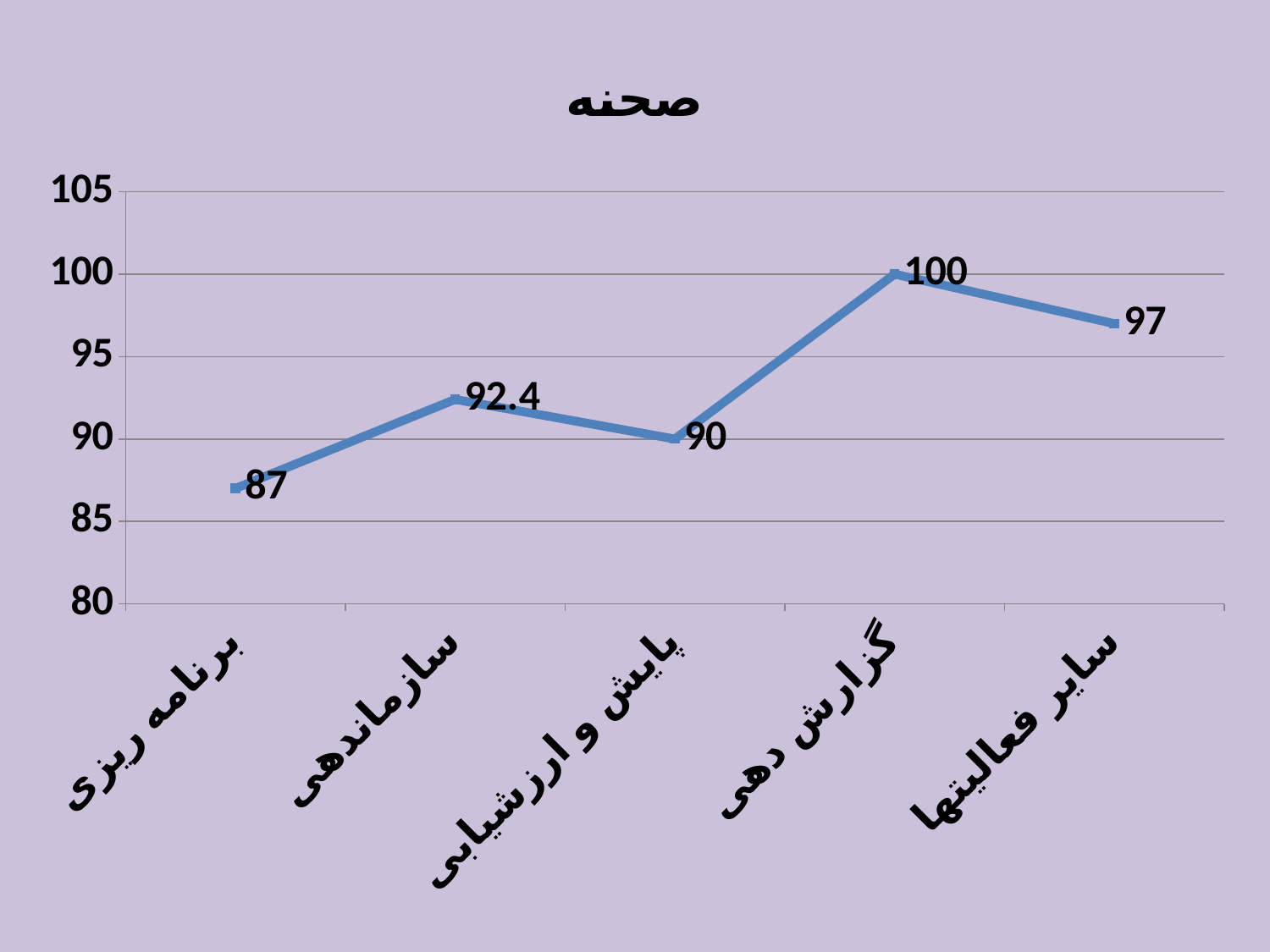
What is the value for سایر فعالیتها? 97 What is the difference between the values for گزارش دهی and پایش و ارزشیابی? 10 What kind of chart is shown on the slide? line chart How many categories are plotted on the x axis? 5 Is the value for سایر فعالیتها greater or less than 95? greater What is the value for گزارش دهی? 100 Which category has the highest value? گزارش دهی What is the value for سازماندهی? 92.4 Which is larger, the value for سازماندهی or the value for پایش و ارزشیابی? سازماندهی Which category has the lowest value? برنامه ریزی What is the value for برنامه ریزی? 87 What is the title of the chart? صحنه